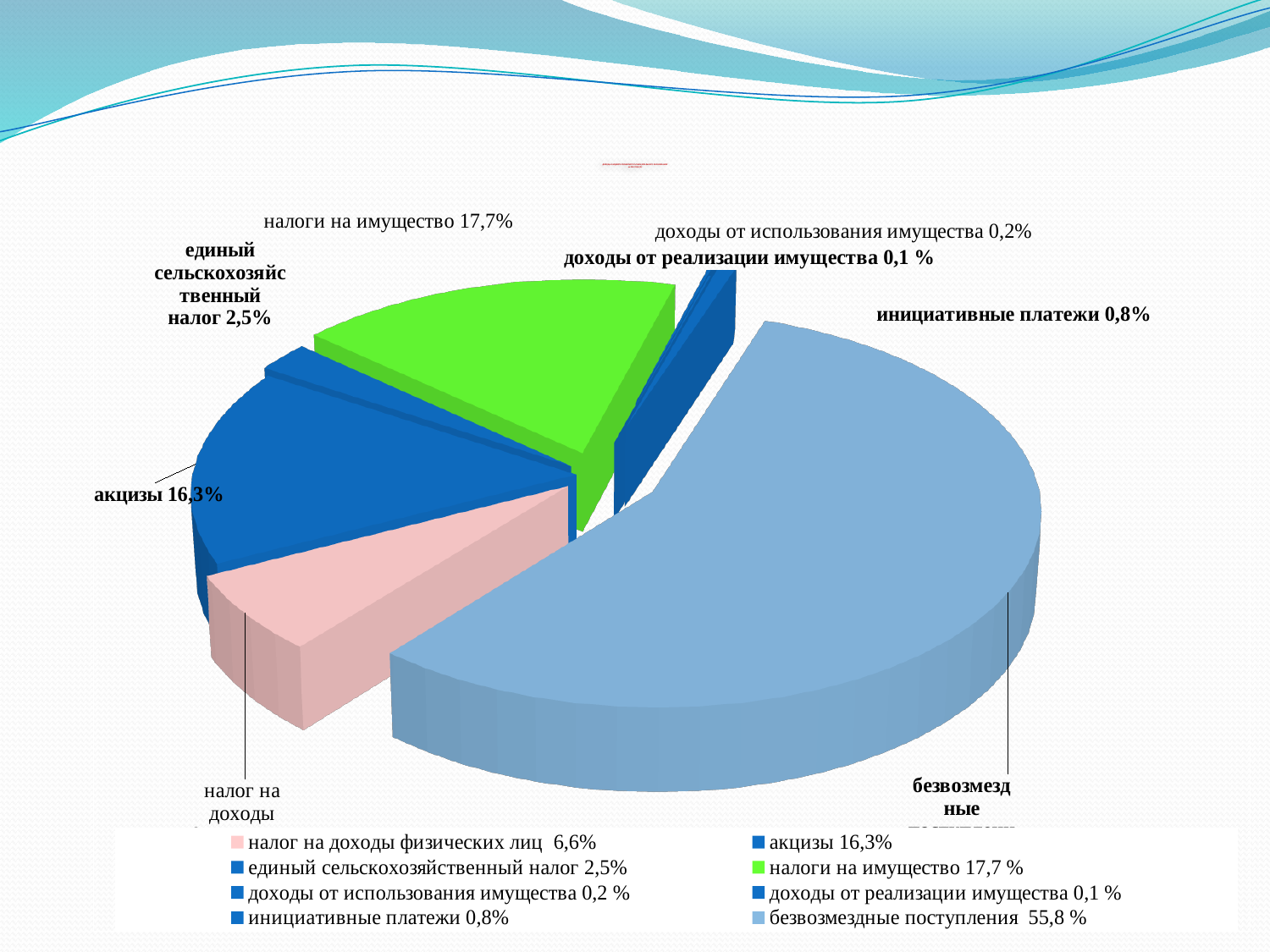
Which category has the largest share of the pie? безвозмездные поступления What percentage is shown for акцизы? 16,3% What percentage is shown for налог на доходы физических лиц? 6,6% Which is larger, the share for акцизы or the share for налоги на имущество? налоги на имущество What percentage is shown for налоги на имущество? 17,7 % What share of the pie is labelled for безвозмездные поступления? 55,8 % How many categories does the legend list? 8 What is the difference in percentage points between налоги на имущество (17,7 %) and акцизы (16,3%)? 1,4 What kind of chart is shown on the slide? pie chart What percentage is shown for единый сельскохозяйственный налог? 2,5% Which category has the smallest share of the pie? доходы от реализации имущества What colour is the slice for налог на доходы физических лиц? pink